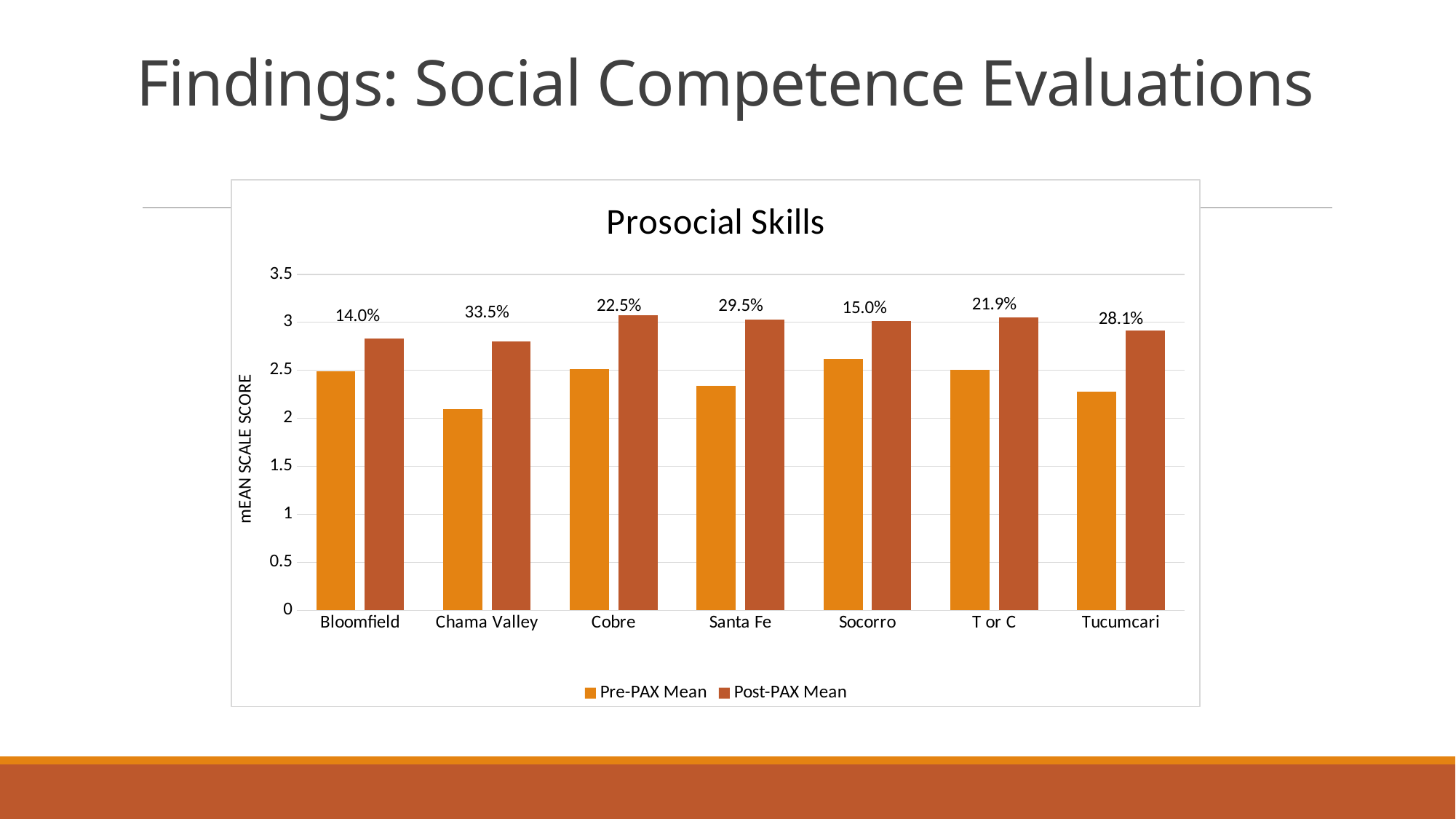
Is the Pre-PAX Mean value for Chama Valley greater or less than 2.5? less What kind of chart is shown on the slide? Bar chart How many school categories are shown on the x axis? 7 What percentage label is shown above the bars for Chama Valley? 33.5% Is the Pre-PAX Mean value for Socorro greater or less than 2.5? greater What is the title of the chart? Prosocial Skills Which category has the lowest Pre-PAX Mean value? Chama Valley What percentage label is shown above the bars for Santa Fe? 29.5% Which category has the highest percentage label? Chama Valley How many series does the legend list? 2 What percentage label is shown above the bars for T or C? 21.9% Which category has the lowest percentage label? Bloomfield